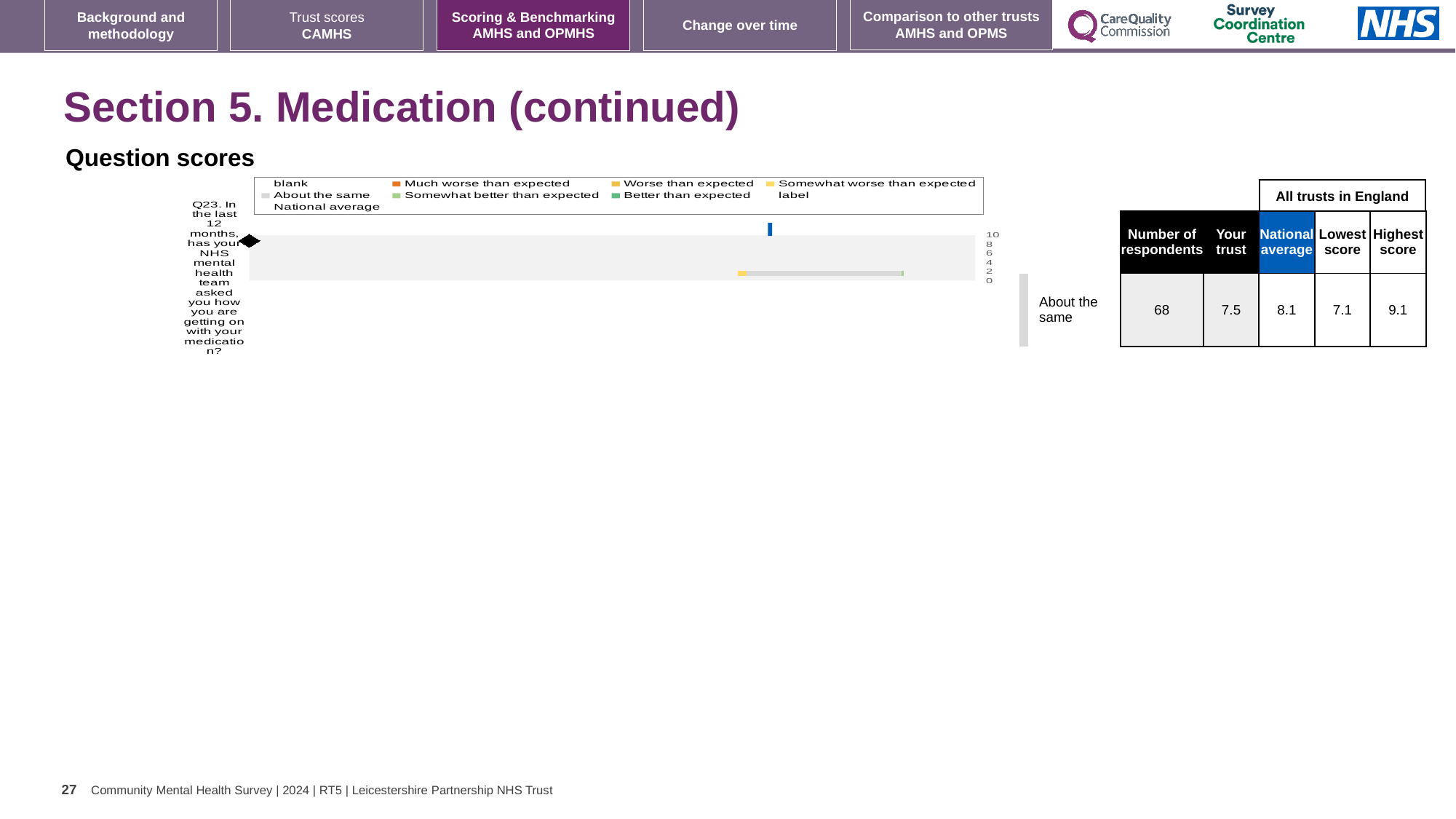
How many entries does the chart's legend list? 9 How many question categories are plotted on the chart? 1 What is the highest value shown on the chart's numeric axis? 10 Which legend entry is shown in orange? Much worse than expected What kind of chart is shown under 'Question scores'? bar chart Which comparison category label is shown next to the chart for Q23? About the same